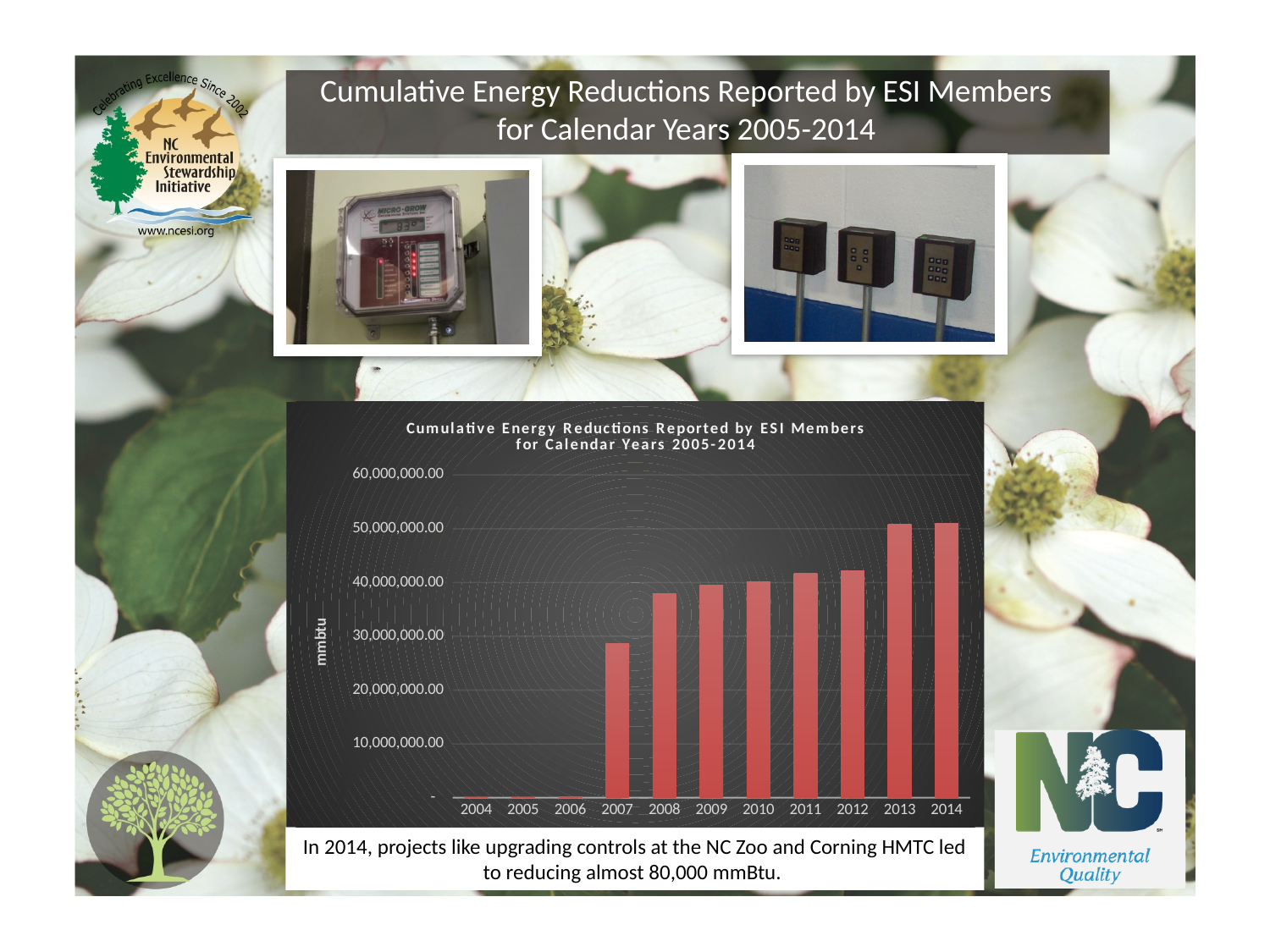
Is the value for 2008 greater or less than 30,000,000.00? greater What kind of chart is shown on the slide? bar chart What is the title of the chart? Cumulative Energy Reductions Reported by ESI Members for Calendar Years 2005-2014 What is the label on the vertical axis of the chart? mmbtu Is the value for 2012 greater or less than 40,000,000.00? greater Is the value for 2007 greater or less than 30,000,000.00? less Which year has the larger value, 2007 or 2008? 2008 Do the values generally rise or fall from 2004 to 2014? rise Which year has the larger value, 2006 or 2007? 2007 How many years are shown on the x axis of the chart? 11 Which year has the larger value, 2012 or 2013? 2013